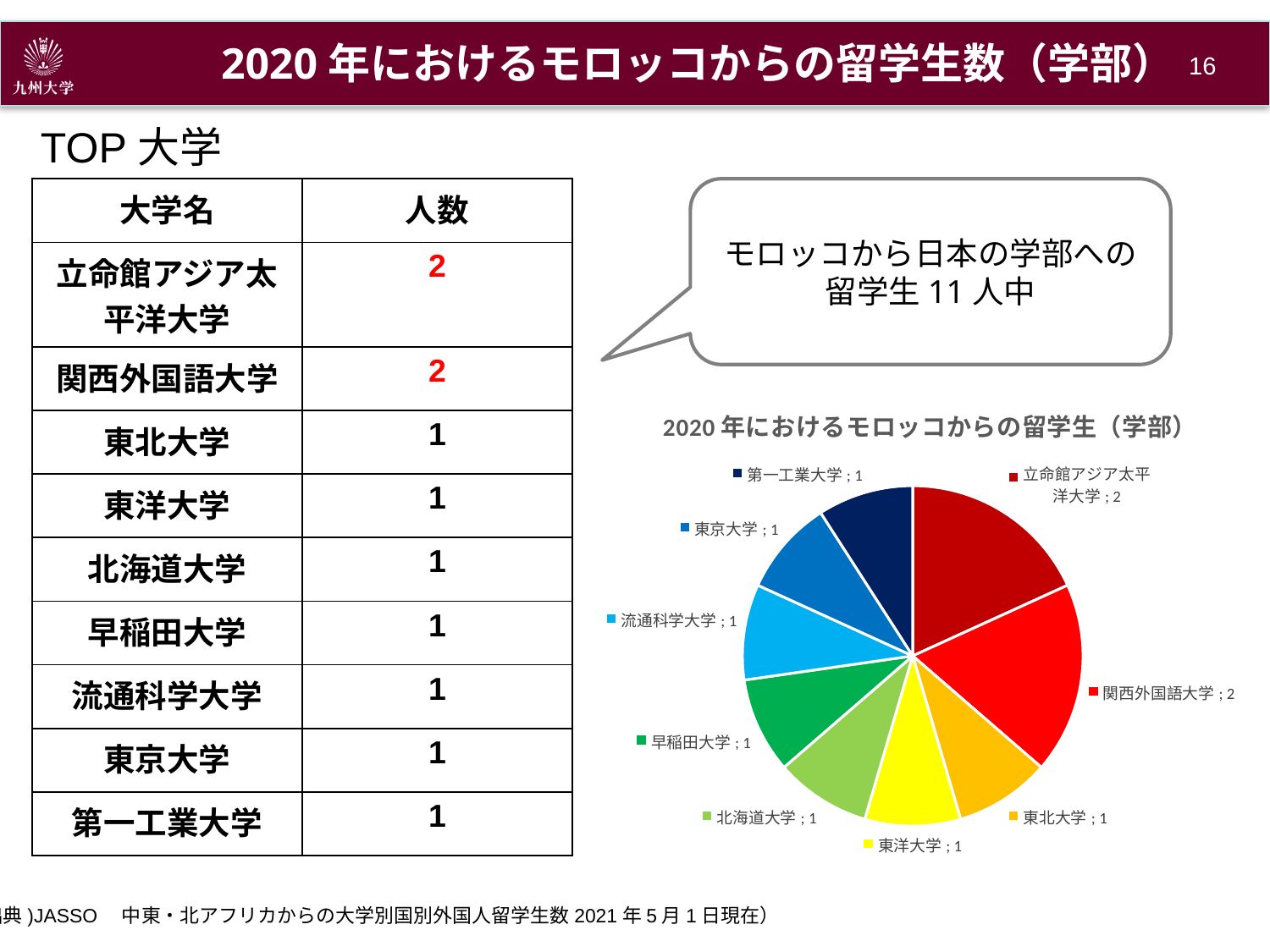
What colour is the slice for 東洋大学 in the pie chart? Yellow What is the value shown for 立命館アジア太平洋大学 in the pie chart? 2 What is the value shown for 東京大学 in the pie chart? 1 How many universities in the pie chart have a value of 1? 7 What is the title of the pie chart? 2020年におけるモロッコからの留学生（学部） What kind of chart is shown on the slide? Pie chart What is the value shown for 関西外国語大学 in the pie chart? 2 Which universities have the largest slices in the pie chart? 立命館アジア太平洋大学 and 関西外国語大学 What is the total of all the values shown in the pie chart? 11 What is the difference between the value for 関西外国語大学 and the value for 早稲田大学 in the pie chart? 1 Which is larger in the pie chart, the value for 立命館アジア太平洋大学 or the value for 東北大学? 立命館アジア太平洋大学 How many slices does the pie chart have? 9